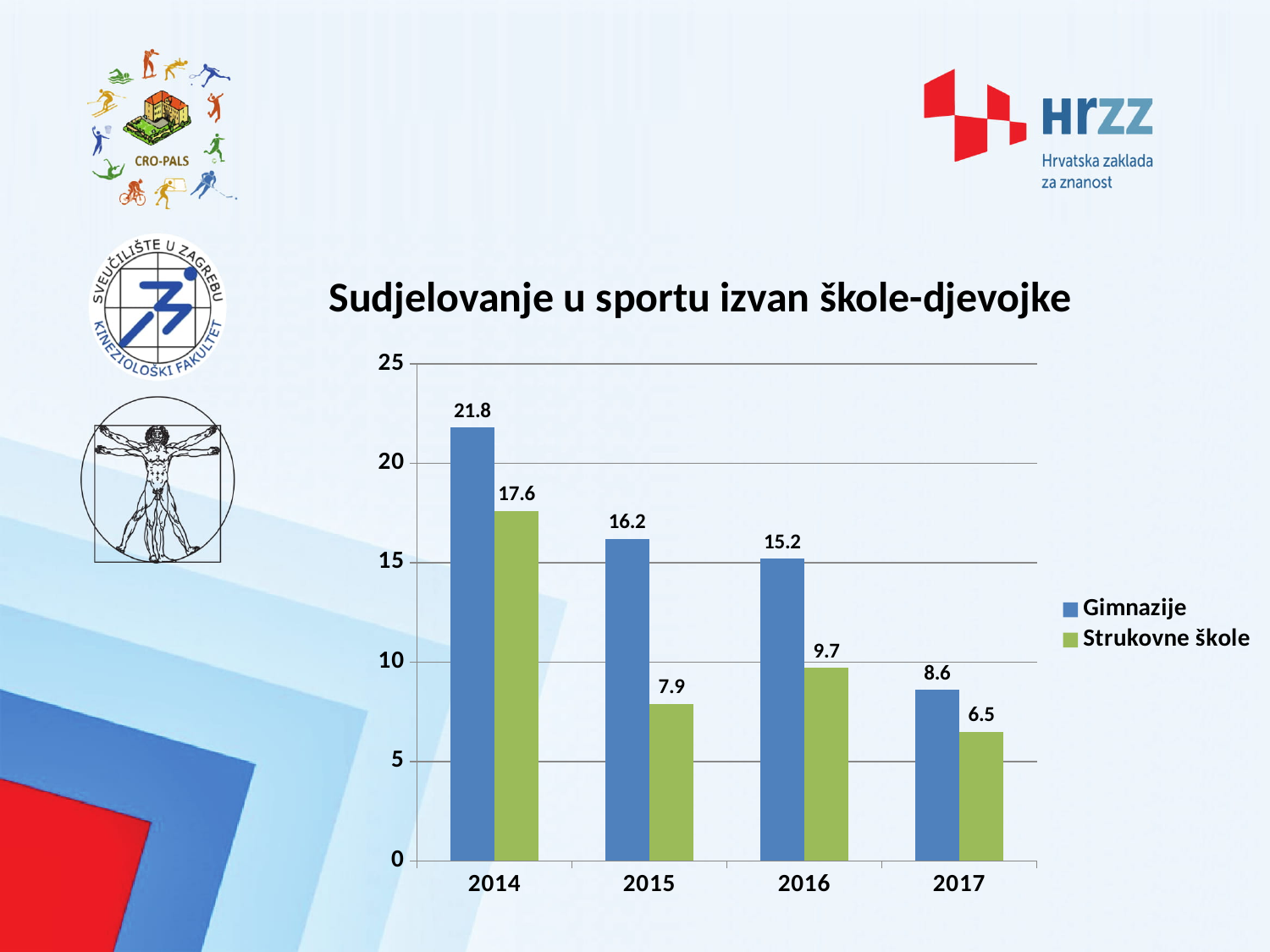
What is the value for Strukovne škole in 2016? 9.7 Do the Gimnazije values rise or fall from 2014 to 2017? fall In which year is the Gimnazije value highest? 2014 What kind of chart is shown? bar chart How many years are shown on the x axis? 4 Is the value for Gimnazije in 2017 greater or less than 10? less In which year is the Strukovne škole value lowest? 2017 What is the value for Strukovne škole in 2017? 6.5 What is the value for Gimnazije in 2014? 21.8 How many series does the legend list? 2 What is the difference between the Gimnazije and Strukovne škole values in 2015? 8.3 Which is larger in 2016, Gimnazije or Strukovne škole? Gimnazije